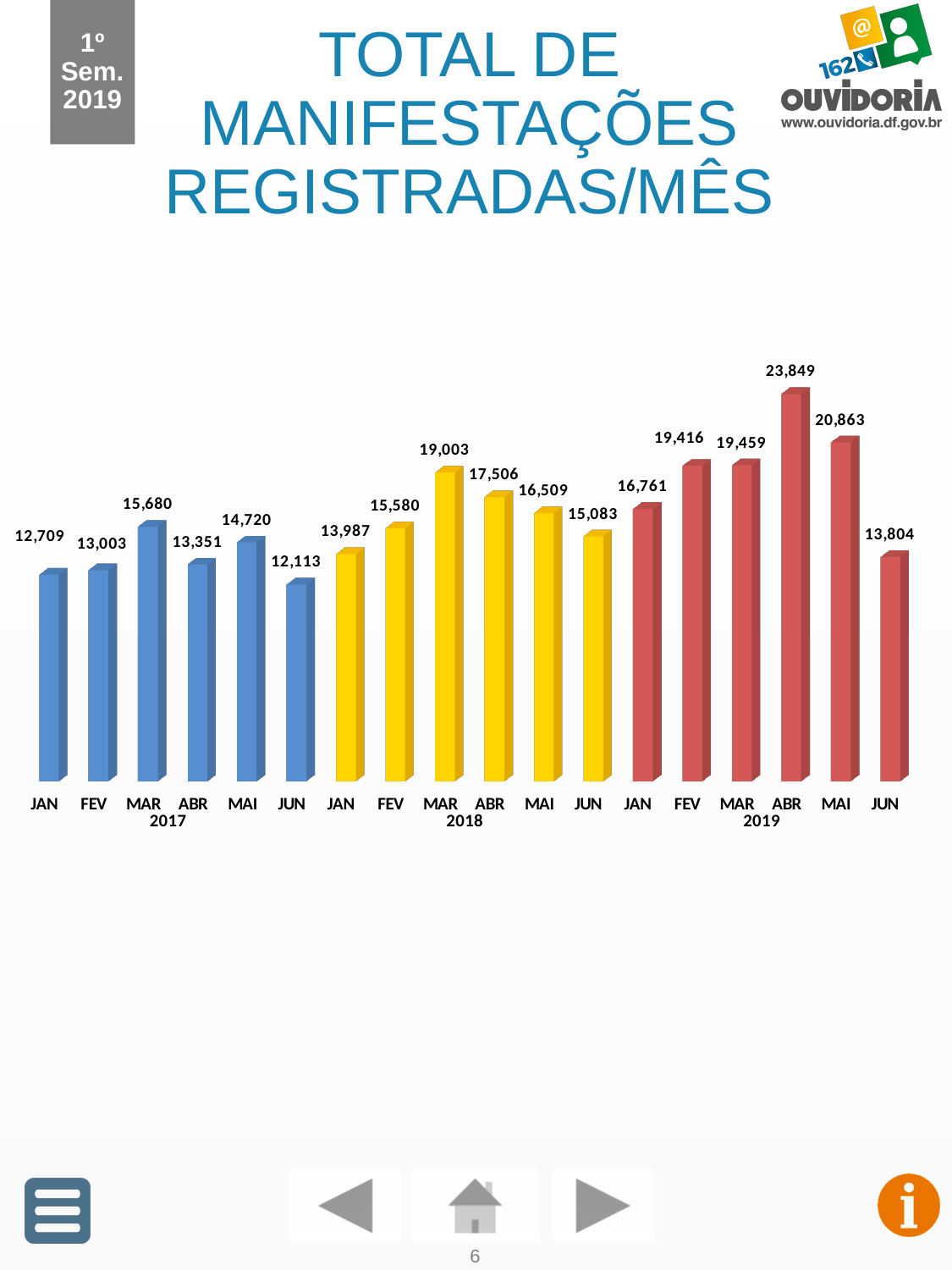
Which is larger, the value for MAI 2017 or the value for MAI 2018? MAI 2018 Which month has the lowest value on the chart? JUN 2017 What is the difference between the values for MAR 2018 and MAR 2017? 3,323 What is the value for JAN 2017? 12,709 Which month has the highest value on the chart? ABR 2019 Do the values rise or fall from JAN 2019 to ABR 2019? Rise What is the value for JUN 2019? 13,804 How many bars are plotted on the chart? 18 What is the value for MAR 2018? 19,003 What is the title of the chart on the slide? TOTAL DE MANIFESTAÇÕES REGISTRADAS/MÊS What kind of chart is shown on the slide? Bar chart What is the difference between the values for ABR 2019 and MAI 2019? 2,986